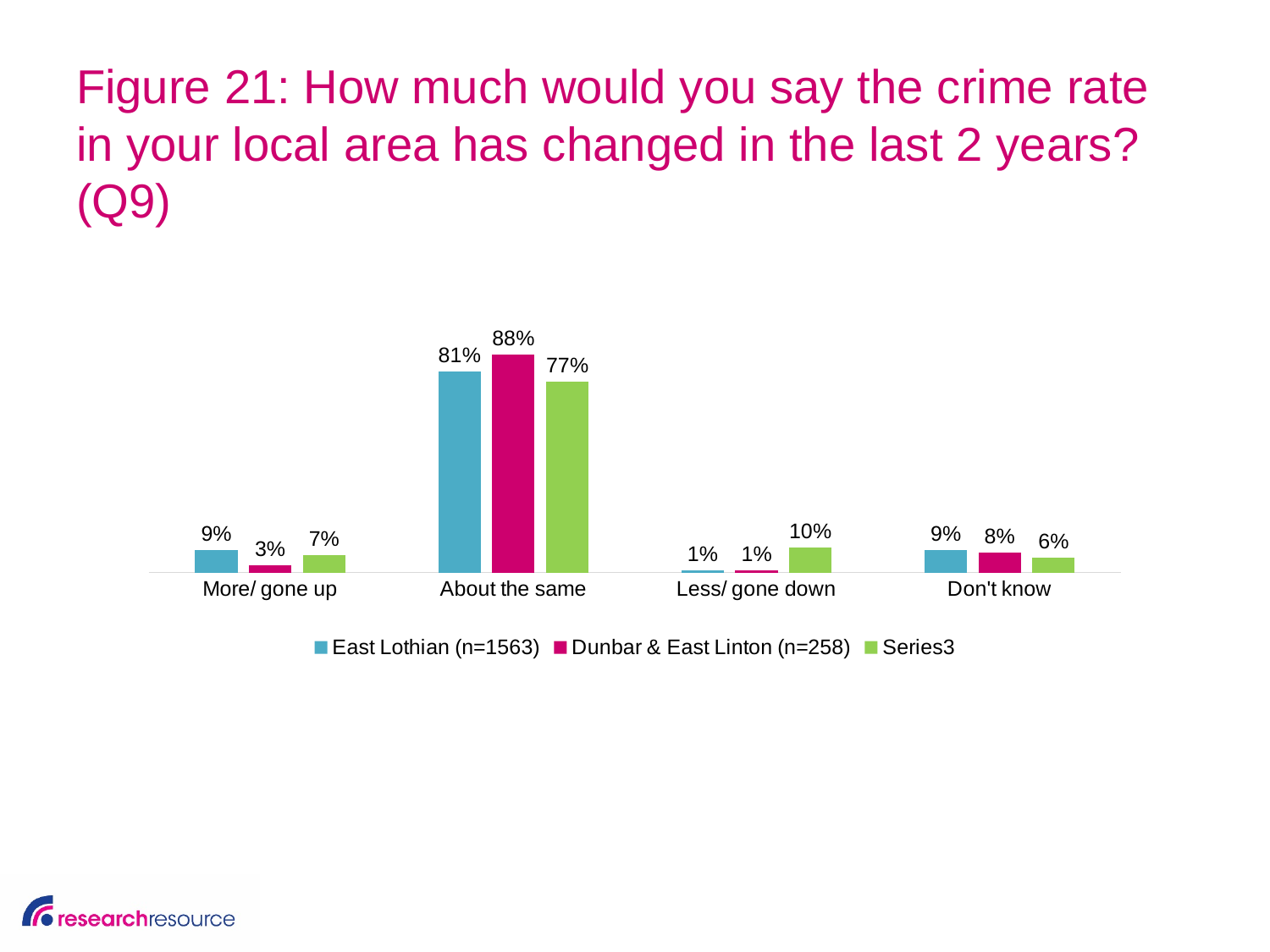
Which is larger in the 'More/ gone up' category: East Lothian (n=1563) or Series3? East Lothian (n=1563) What type of chart is shown on the slide? Bar chart What is the value for Dunbar & East Linton (n=258) in the 'More/ gone up' category? 3% What colour are the bars for Dunbar & East Linton (n=258)? Pink/magenta Which category has the highest value for Dunbar & East Linton (n=258)? About the same Which category has the lowest value for East Lothian (n=1563)? Less/ gone down What is the Series3 value for 'Less/ gone down'? 10% How many series does the legend list? 3 What is the value for Dunbar & East Linton (n=258) in the 'Don't know' category? 8% What percentage of East Lothian (n=1563) respondents said the crime rate was 'About the same'? 81% How many categories are shown on the x axis? 4 What is the difference between the Dunbar & East Linton (n=258) and East Lothian (n=1563) values for 'About the same'? 7%